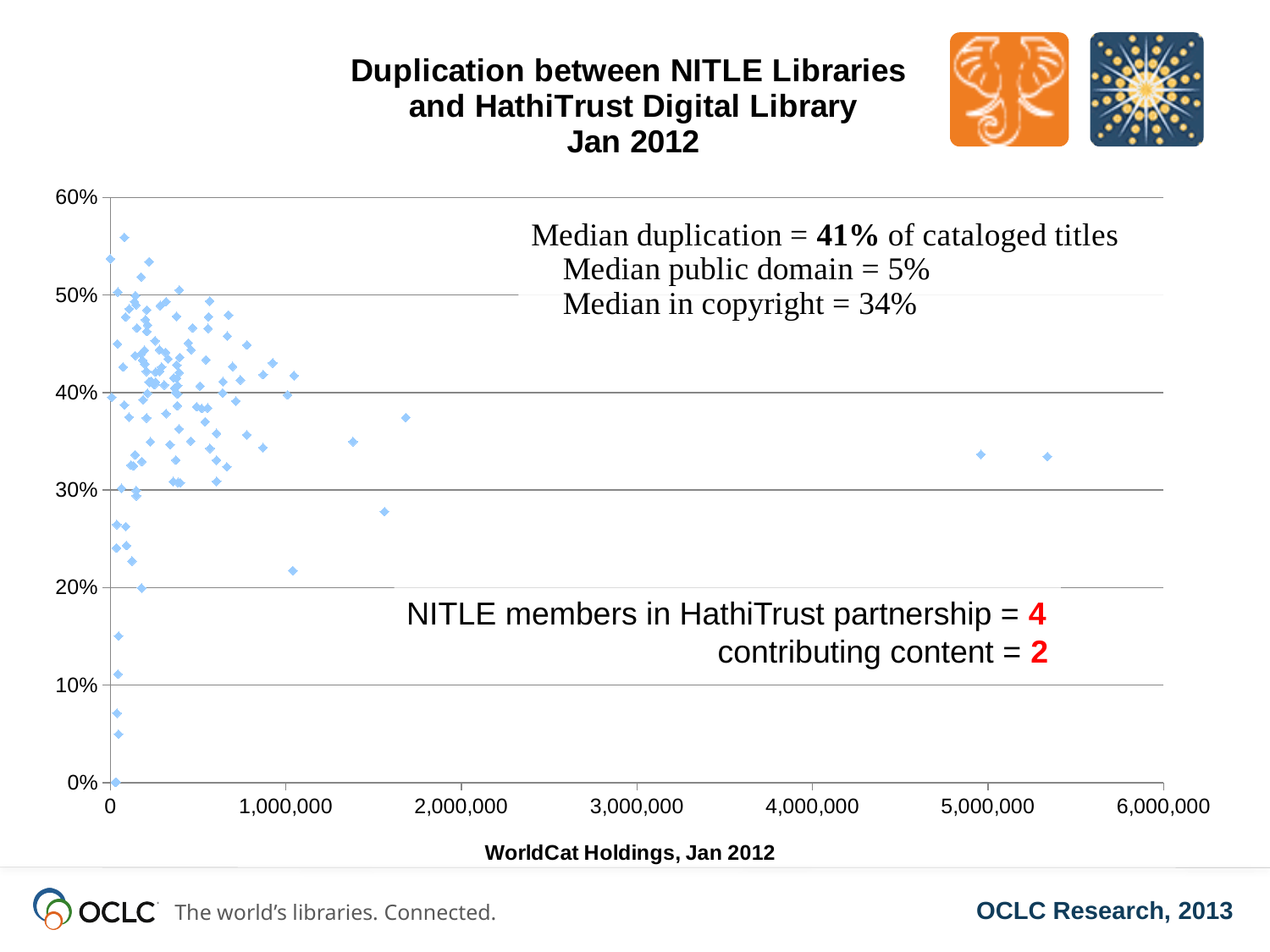
According to the annotation on the chart, what is the median in copyright percentage? 34% What is the label of the x axis? WorldCat Holdings, Jan 2012 According to the chart annotation, how many NITLE members are in the HathiTrust partnership? 4 Is the duplication value for the point with the largest WorldCat holdings greater or less than 30%? greater According to the annotation on the chart, what is the median duplication of cataloged titles? 41% Is the largest WorldCat holdings value plotted greater or less than 5,000,000? greater What is the title of the chart? Duplication between NITLE Libraries and HathiTrust Digital Library Jan 2012 Is the highest duplication value plotted greater or less than 50%? greater According to the annotation on the chart, what is the median public domain percentage? 5% According to the chart annotation, how many NITLE members are contributing content? 2 What kind of chart is shown on the slide? scatter plot